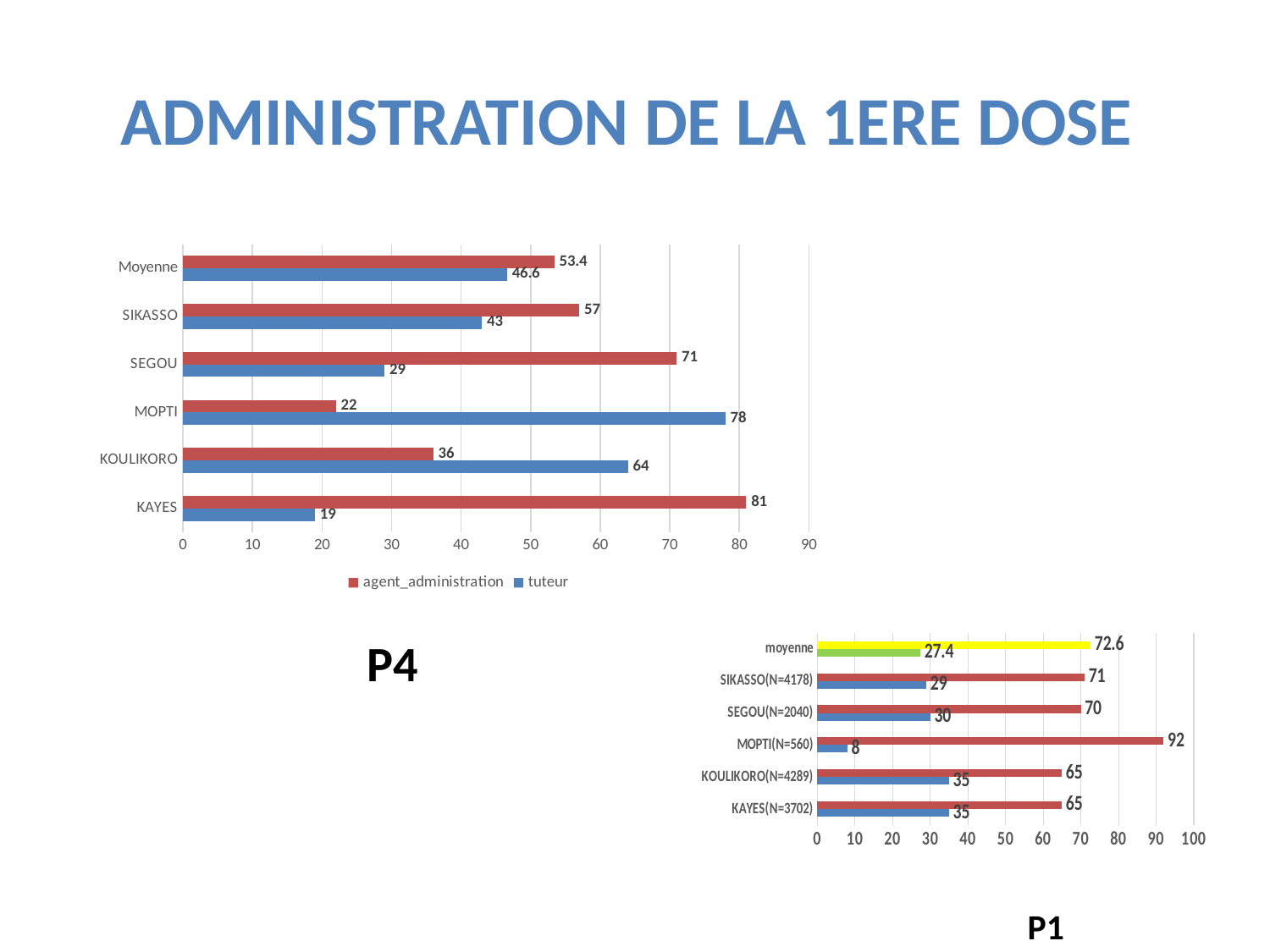
In the bottom-right chart (P1), which category has the lowest blue bar value? MOPTI(N=560) In the top-left chart (P4), which is larger for KOULIKORO, agent_administration or tuteur? tuteur In the top-left chart (P4), what is the difference between the agent_administration and tuteur values for SEGOU? 42 What type of chart is the top-left chart (P4)? bar chart In the bottom-right chart (P1), what is the value of the green bar for moyenne? 27.4 In the top-left chart (P4), what is the agent_administration value for KAYES? 81 In the bottom-right chart (P1), what is the value of the red bar for MOPTI(N=560)? 92 In the top-left chart (P4), which region has the lowest tuteur value? KAYES In the top-left chart (P4), what is the tuteur value for Moyenne? 46.6 In the top-left chart (P4), which region has the highest agent_administration value? KAYES How many series does the legend of the top-left chart (P4) list? 2 In the top-left chart (P4), what is the tuteur value for MOPTI? 78